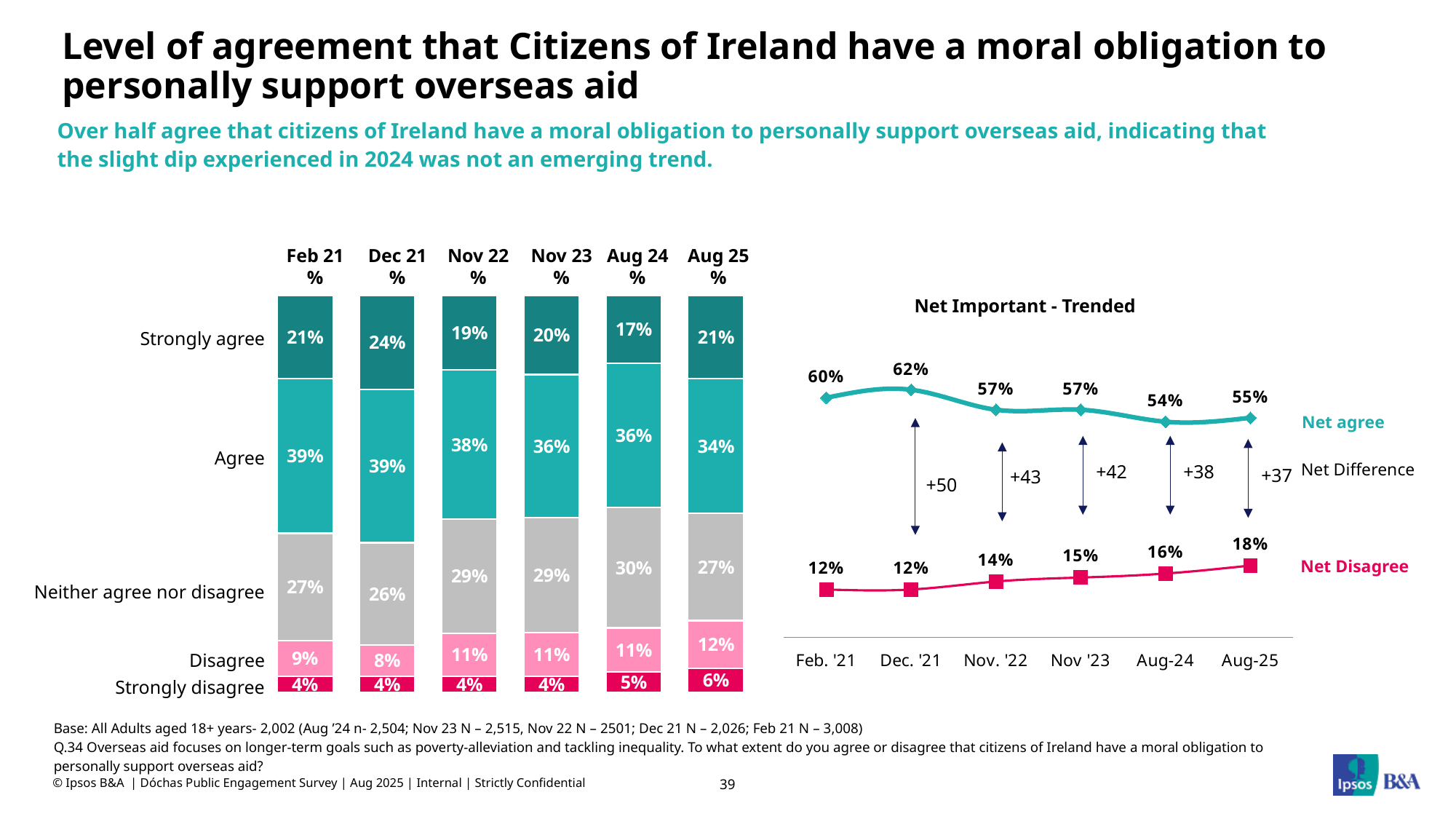
In the 'Net Important - Trended' chart, what is the Net Disagree value for Aug-25? 18% In the 'Net Important - Trended' chart, does Net Disagree rise or fall from Feb. '21 to Aug-25? Rise In the stacked bar chart on the left, which wave has the highest 'Strongly agree' percentage? Dec 21 In the stacked bar chart on the left, how many survey waves are shown? 6 In the stacked bar chart on the left, what percentage strongly agreed in Aug 25? 21% In the 'Net Important - Trended' chart, what is the Net Difference shown for Nov '23? +42 In the stacked bar chart on the left, which wave has the lowest 'Strongly agree' percentage? Aug 24 What type of chart is 'Net Important - Trended'? Line chart In the stacked bar chart on the left, what percentage strongly disagreed in Aug 24? 5% In the 'Net Important - Trended' chart, what is the Net agree value for Dec. '21? 62% In the stacked bar chart on the left, what percentage chose 'Agree' in Nov 22? 38% In the stacked bar chart on the left, what is the difference between the 'Agree' percentage in Feb 21 and in Aug 25? 5 percentage points